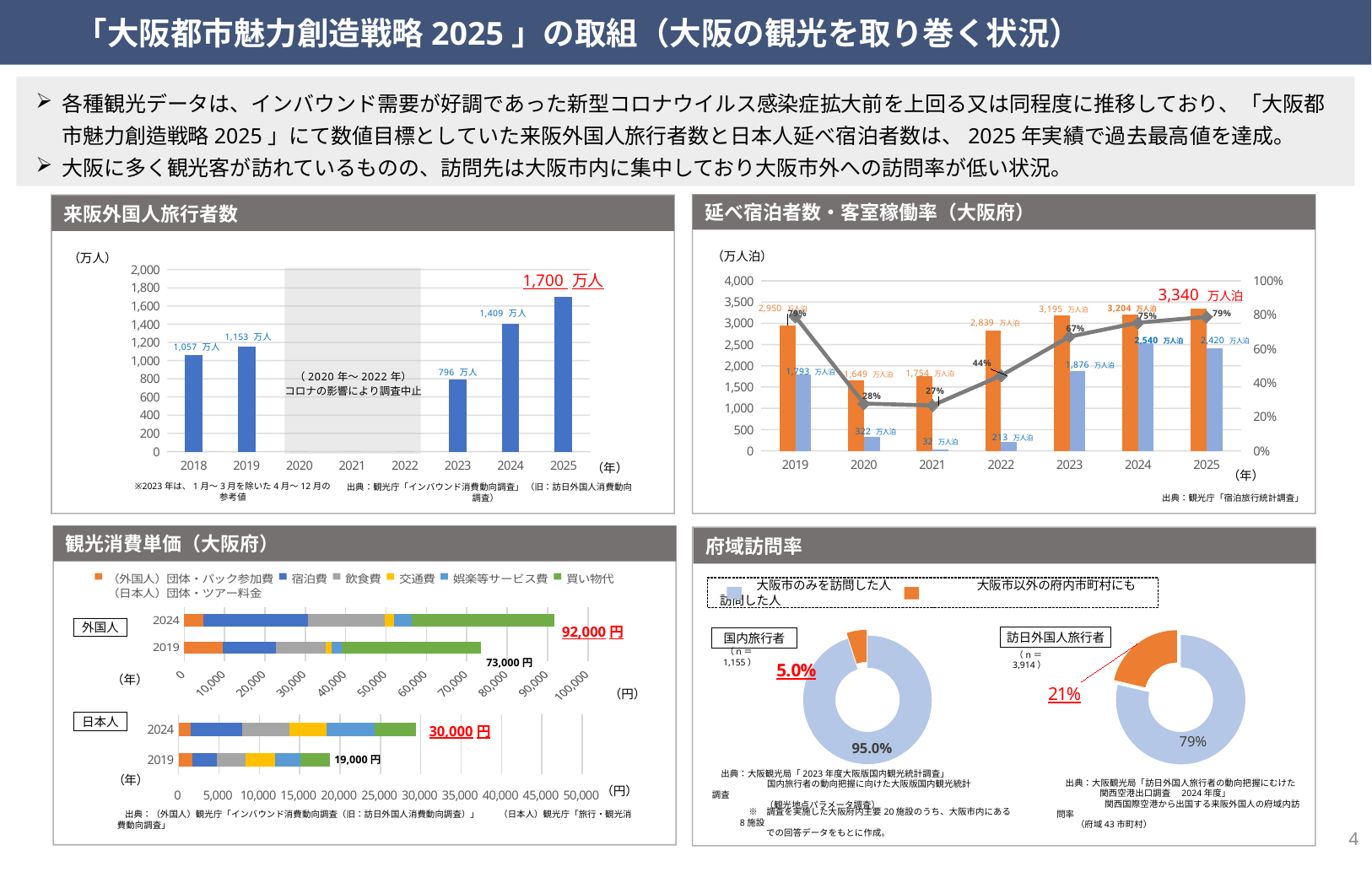
In the 観光消費単価（大阪府） chart, what is the total for 外国人 in 2019? 73,000 円 In the 来阪外国人旅行者数 chart, what is the value for 2025? 1,700 万人 In the 延べ宿泊者数・客室稼働率（大阪府） chart, what is the value of the blue bar for 2024? 2,540 万人泊 In the 来阪外国人旅行者数 chart, which year has the lowest number of visitors among the plotted bars? 2023 In the 延べ宿泊者数・客室稼働率（大阪府） chart, what is the 客室稼働率 for 2021? 27% In the 来阪外国人旅行者数 chart, how many years have a bar plotted? 5 In the 府域訪問率 chart, what share of 訪日外国人旅行者 visited municipalities outside Osaka City? 21% What type of chart is used in the 府域訪問率 panel? Donut (pie) chart In the 延べ宿泊者数・客室稼働率（大阪府） chart, is the orange bar for 2020 larger or smaller than the orange bar for 2022? smaller In the 延べ宿泊者数・客室稼働率（大阪府） chart, which year has the highest orange bar? 2025 In the 観光消費単価（大阪府） chart, what is the difference between the 日本人 totals for 2024 and 2019? 11,000 円 In the 来阪外国人旅行者数 chart, what is the difference between the 2025 value and the 2024 value? 291 万人